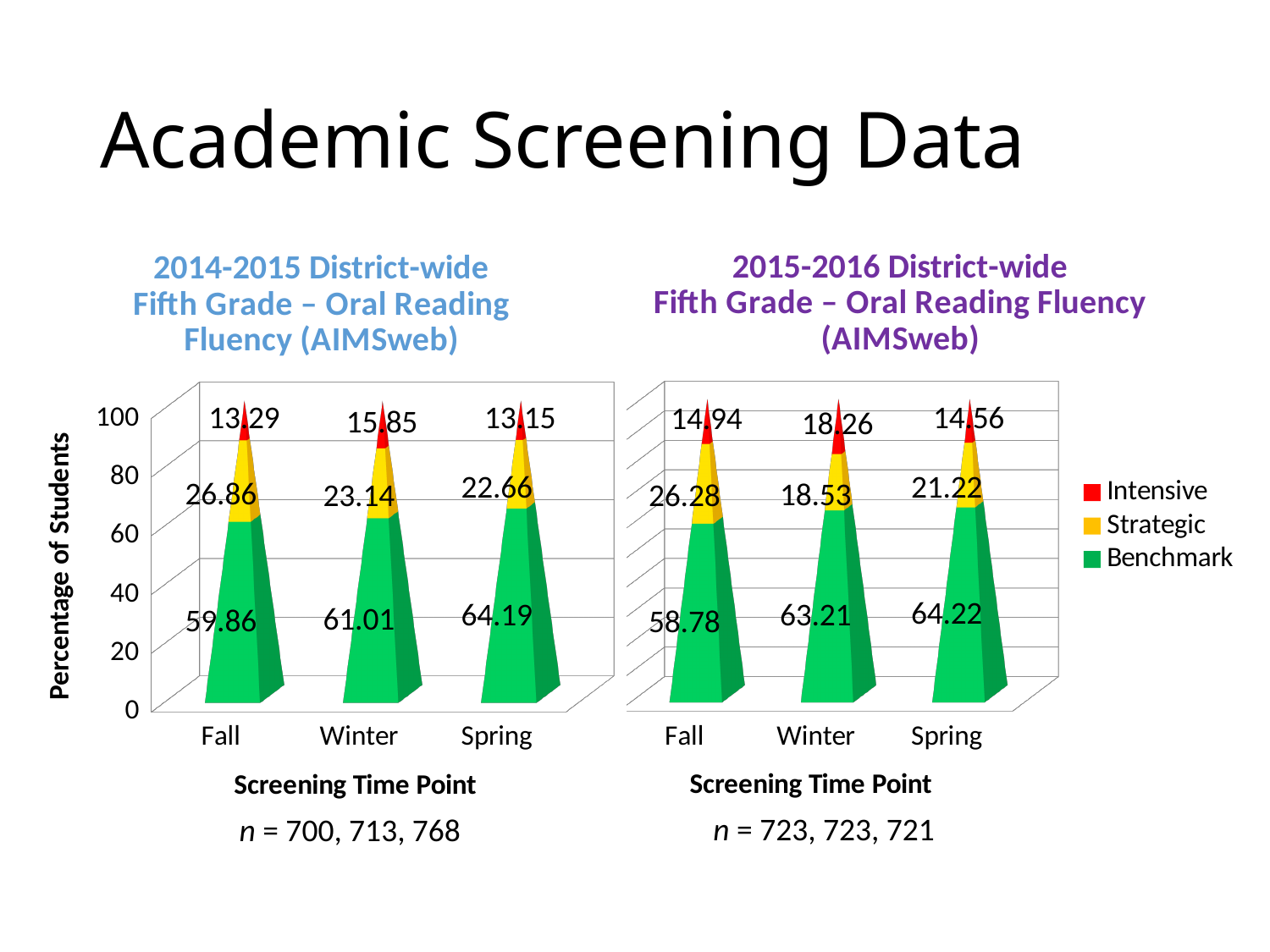
How many series does the legend list? 3 In the 2014-2015 chart, what is the difference between the Benchmark values for Spring and Fall? 4.33 In the 2015-2016 chart, what is the Intensive value for Winter? 18.26 How many screening time points are shown in the 2014-2015 chart? 3 In the 2014-2015 chart, what is the Strategic value for Spring? 22.66 In the 2014-2015 chart, which screening time point has the lowest Strategic value? Spring In the 2014-2015 chart, what is the Benchmark value for Fall? 59.86 In the 2015-2016 chart, is the Strategic value larger for Fall or for Winter? Fall In the 2015-2016 chart, does the Benchmark value rise or fall from Fall to Spring? Rise In the 2015-2016 chart, what is the difference between the Intensive values for Winter and Fall? 3.32 In the 2015-2016 chart, which screening time point has the highest Benchmark value? Spring What kind of chart is the 2015-2016 chart? Stacked bar chart